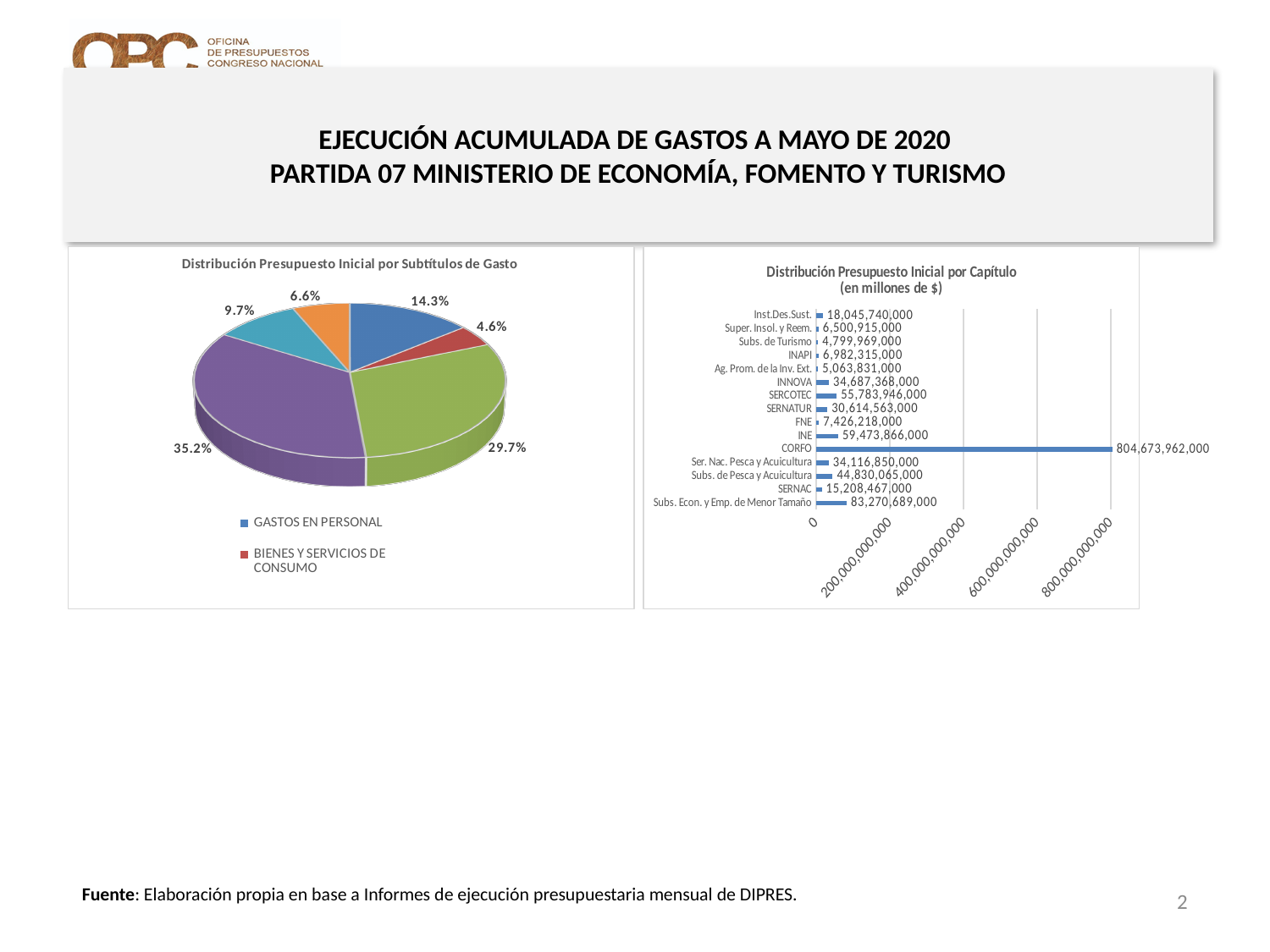
In the pie chart 'Distribución Presupuesto Inicial por Subtítulos de Gasto', what share does BIENES Y SERVICIOS DE CONSUMO have? 4.6% In the bar chart 'Distribución Presupuesto Inicial por Capítulo', what is the value for SERCOTEC? 55,783,946,000 In the bar chart 'Distribución Presupuesto Inicial por Capítulo', which capítulo has the highest value? CORFO In the pie chart 'Distribución Presupuesto Inicial por Subtítulos de Gasto', what share does GASTOS EN PERSONAL have? 14.3% How many capítulos are shown in the bar chart 'Distribución Presupuesto Inicial por Capítulo'? 15 In the bar chart 'Distribución Presupuesto Inicial por Capítulo', what is the difference between INE and SERCOTEC? 3,689,920,000 In the bar chart 'Distribución Presupuesto Inicial por Capítulo', which capítulo has the lowest value? Subs. de Turismo In the bar chart 'Distribución Presupuesto Inicial por Capítulo', what is the value for CORFO? 804,673,962,000 What type of chart is the left chart, 'Distribución Presupuesto Inicial por Subtítulos de Gasto'? Pie chart In the pie chart 'Distribución Presupuesto Inicial por Subtítulos de Gasto', what is the largest slice's percentage? 35.2% How many entries does the legend of the pie chart 'Distribución Presupuesto Inicial por Subtítulos de Gasto' list? 2 What type of chart is the right chart, 'Distribución Presupuesto Inicial por Capítulo'? Bar chart